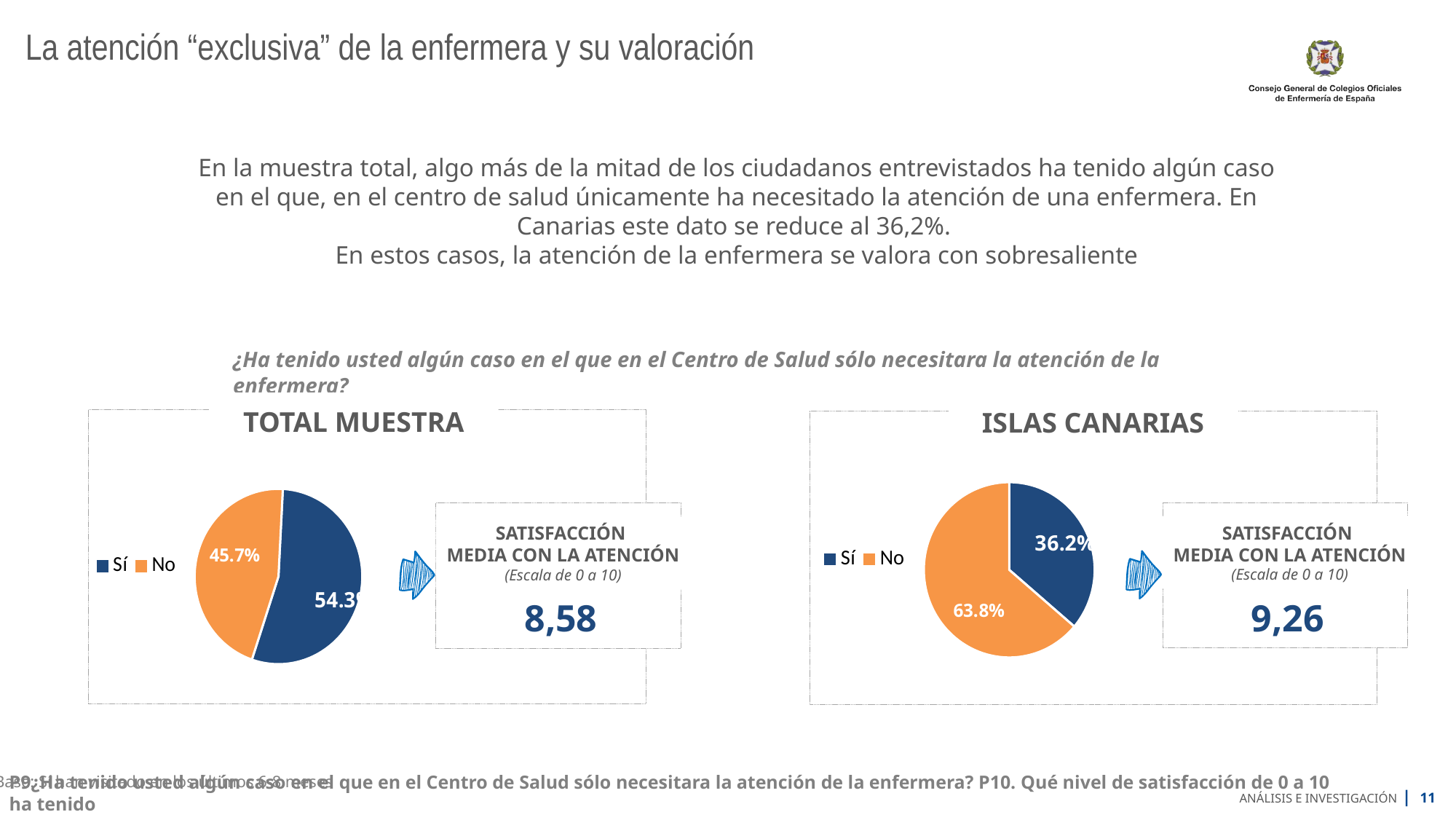
In the ISLAS CANARIAS pie chart, which category has the largest slice? No In the ISLAS CANARIAS pie chart, what share of respondents answered No? 63.8% Is the Sí share larger in the TOTAL MUESTRA pie chart or in the ISLAS CANARIAS pie chart? TOTAL MUESTRA In the ISLAS CANARIAS pie chart, what share of respondents answered Sí? 36.2% What type of chart is used for TOTAL MUESTRA and ISLAS CANARIAS? Pie chart In the ISLAS CANARIAS pie chart, what is the difference between the No and Sí shares? 27.6 percentage points In the TOTAL MUESTRA pie chart, what share of respondents answered Sí? 54.3% In the TOTAL MUESTRA pie chart, which category has the smallest slice? No In the TOTAL MUESTRA pie chart, what colour is the Sí slice? Dark blue In the TOTAL MUESTRA pie chart, what is the difference between the Sí and No shares? 8.6 percentage points In the TOTAL MUESTRA pie chart, what share of respondents answered No? 45.7% How many categories does the legend of the ISLAS CANARIAS pie chart list? 2